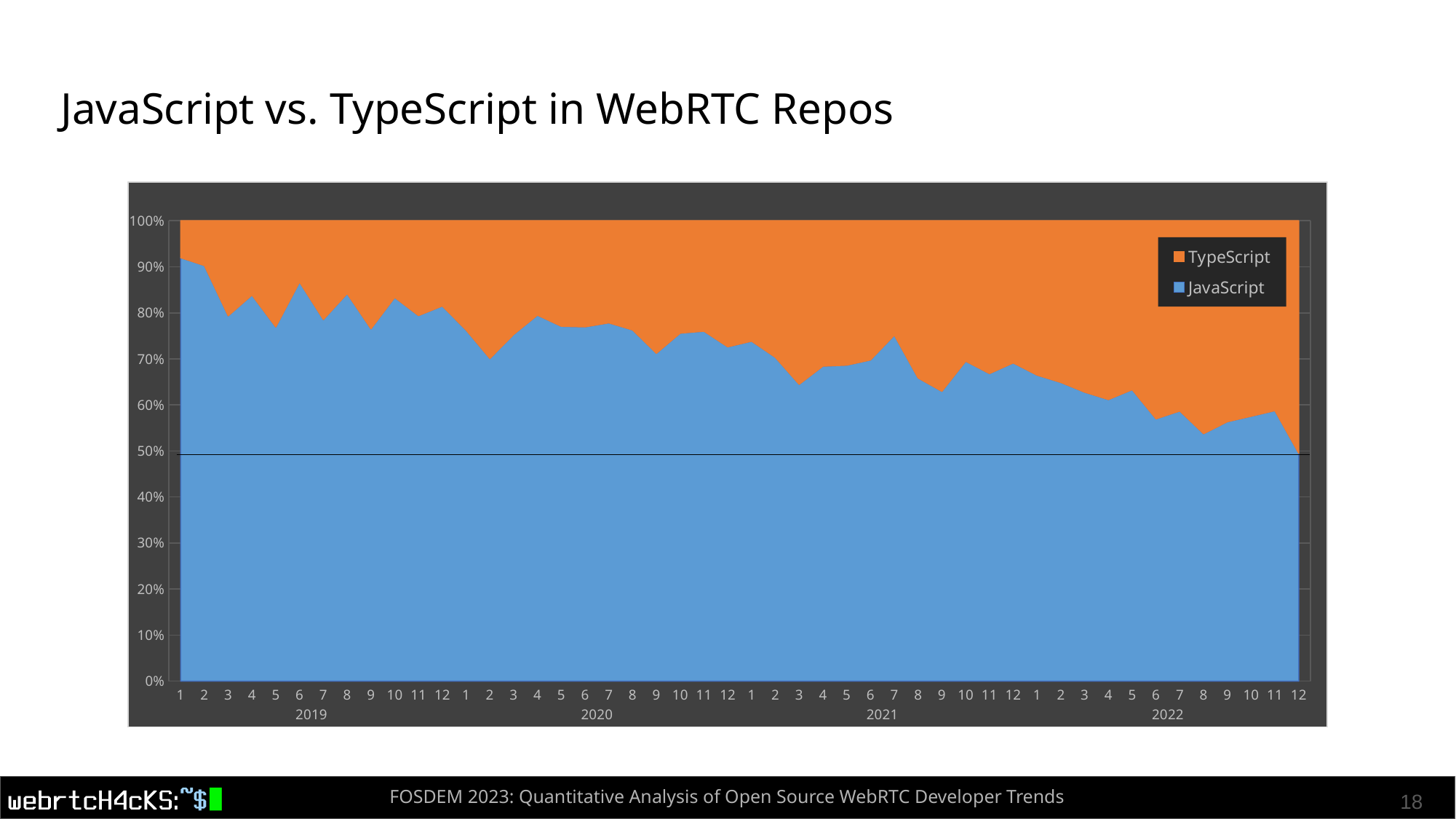
In month 6 of 2019, which is larger, the JavaScript share or the TypeScript share? JavaScript How many years are shown along the x axis? 4 Which series are listed in the legend? TypeScript and JavaScript Does the TypeScript share rise or fall from 2019 to 2022? Rise What is the title of the slide's chart? JavaScript vs. TypeScript in WebRTC Repos What kind of chart is shown on the slide? Stacked area chart Does the JavaScript share rise or fall from 2019 to 2022? Fall How many series does the legend list? 2 Is the JavaScript share in month 12 of 2022 greater or less than 60%? less In which month and year is the JavaScript share at its lowest? Month 12 of 2022 How many monthly data points are plotted along the x axis? 48 Is the JavaScript share in month 1 of 2019 greater or less than 80%? greater